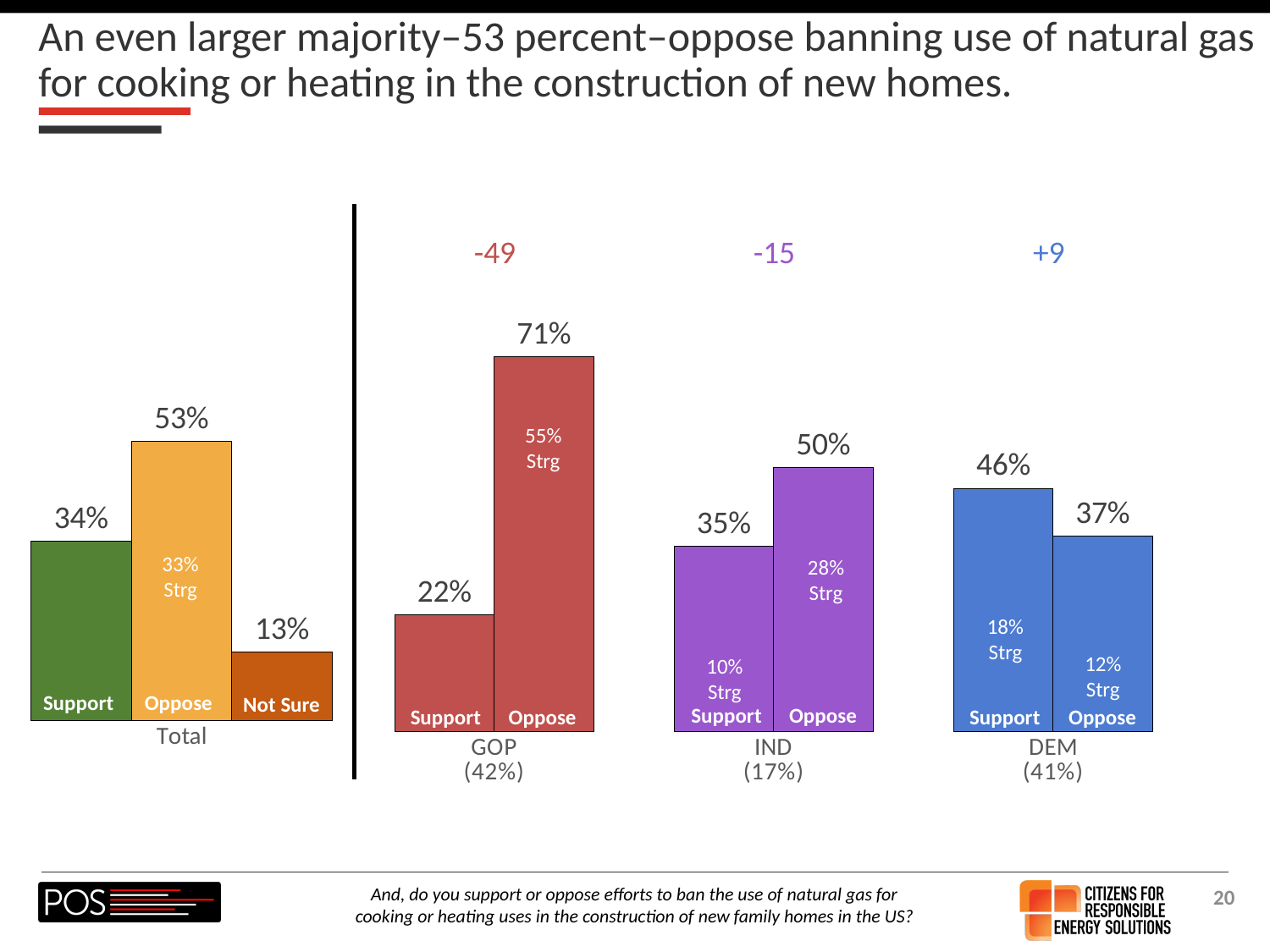
In the right chart (by party), what is the strongly oppose (Strg) percentage shown inside the GOP Oppose bar? 55% In the right chart (by party), what percentage of DEM respondents support? 46% In the left chart (Total), how many bars are shown? 3 In the right chart (by party), which party group has the highest Oppose percentage? GOP In the left chart (Total), what percentage oppose banning natural gas use in new homes? 53% What type of chart is used on this slide? Bar chart In the right chart (by party), is the IND Support value larger or smaller than the IND Oppose value? smaller In the left chart (Total), which category has the lowest value? Not Sure In the right chart (by party), what net figure is shown above the DEM bars? +9 In the right chart (by party), what percentage of GOP respondents oppose? 71% In the left chart (Total), what percentage are Not Sure? 13% In the left chart (Total), what is the difference between the Oppose and Support percentages? 19 percentage points